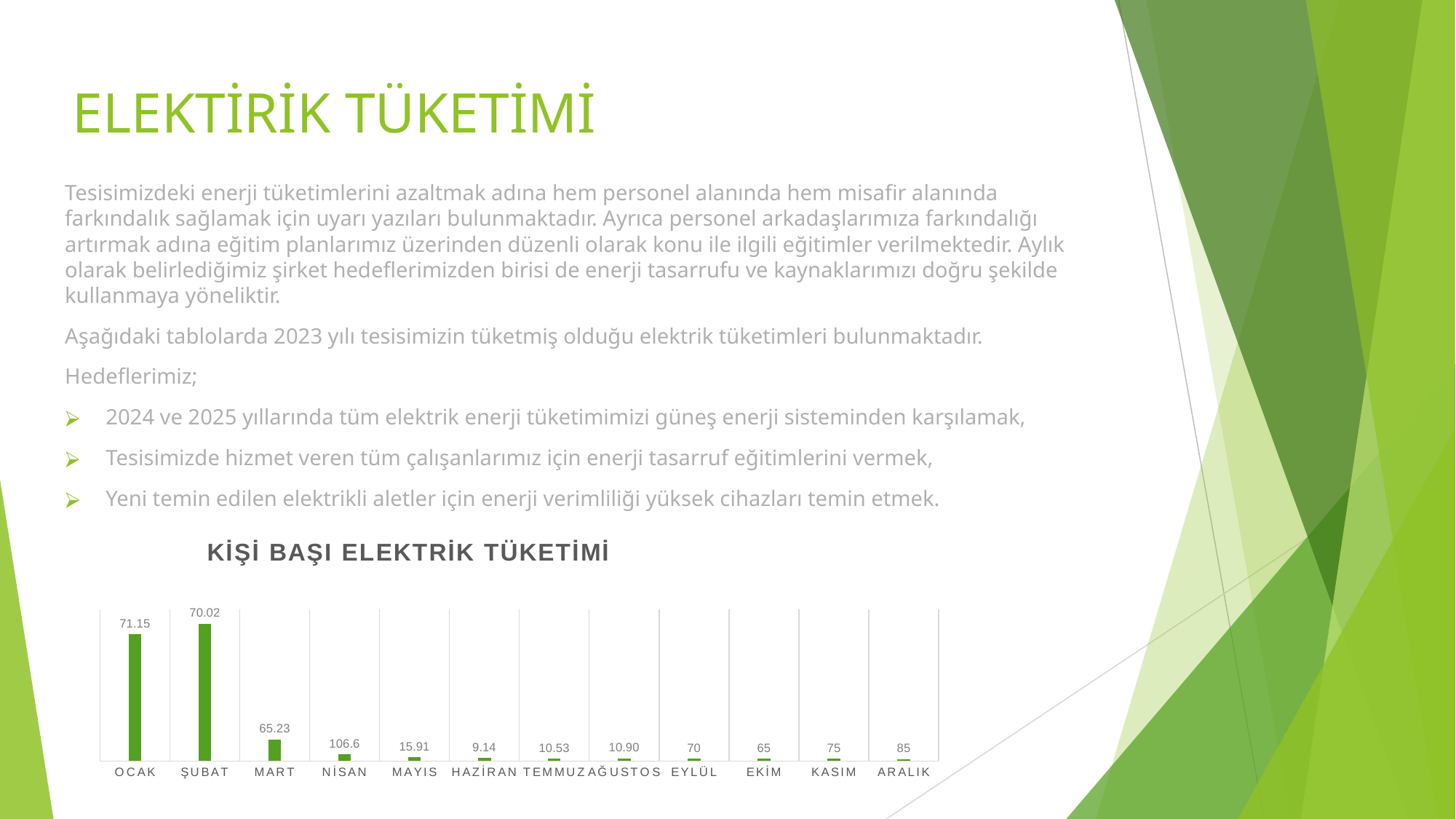
What is the title of the chart? KİŞİ BAŞI ELEKTRİK TÜKETİMİ What is the value shown for ARALIK? 85 What is the value shown for HAZİRAN? 9.14 What is the value shown for NİSAN? 106.6 What is the value shown for MART? 65.23 What is the value shown for AĞUSTOS? 10.90 What is the difference between the values for KASIM and EKİM? 10 How many months (categories) are shown on the chart? 12 What is the value shown for OCAK? 71.15 What is the difference between the values for OCAK and ŞUBAT? 1.13 What type of chart is shown on the slide? bar chart What is the value shown for ŞUBAT? 70.02